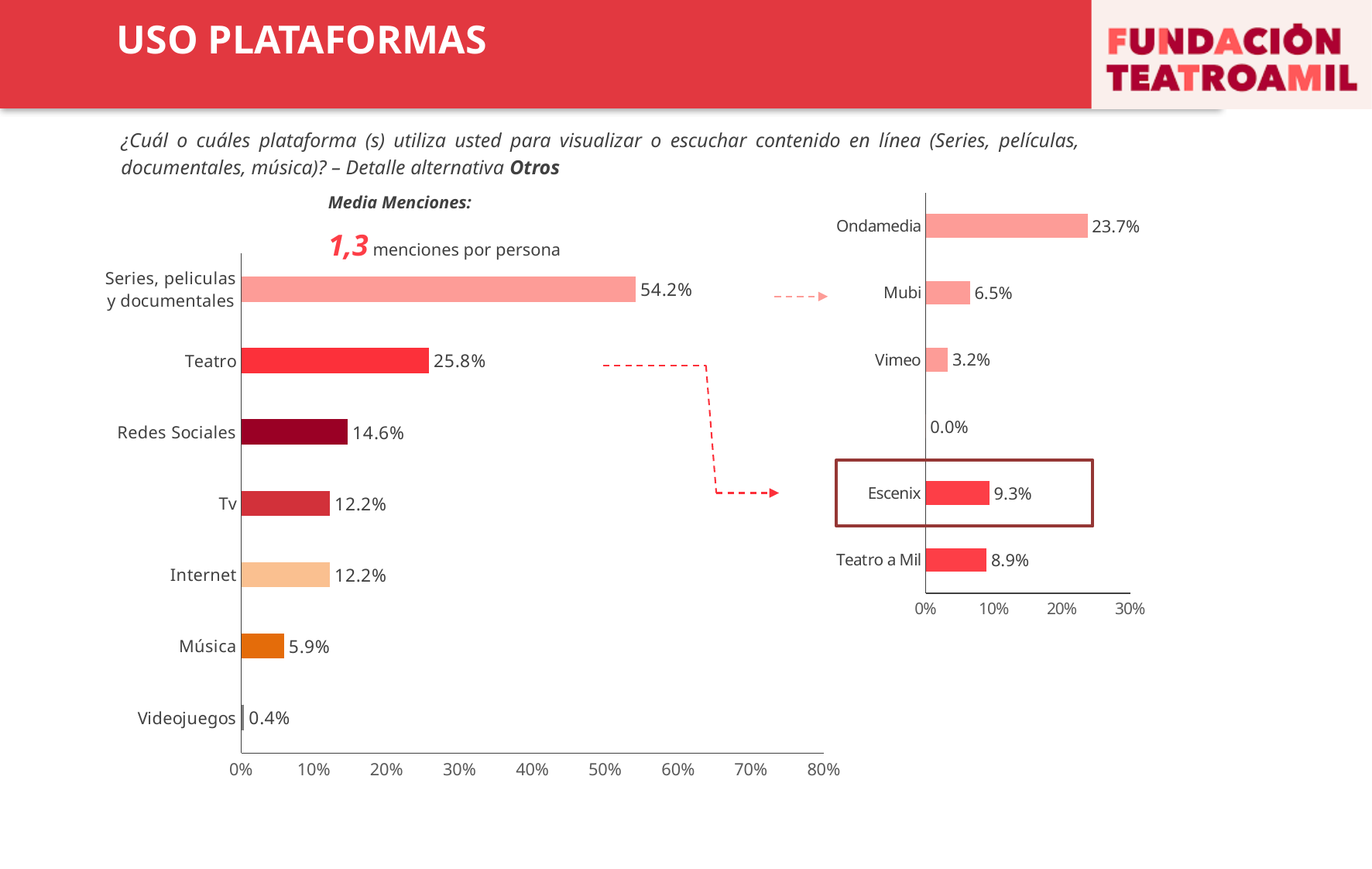
In the left chart, which category has the lowest value? Videojuegos What kind of chart is the left chart? Bar chart In the left chart, how many categories are shown? 7 In the right chart, what is the value for Escenix? 9.3% In the right chart, what is the value for Ondamedia? 23.7% In the right chart, which is larger, Mubi or Vimeo? Mubi In the left chart, what is the value for Teatro? 25.8% In the left chart, is the value for Series, peliculas y documentales greater or less than 50%? greater In the left chart, what is the value for Redes Sociales? 14.6% In the left chart, which category has the highest value? Series, peliculas y documentales In the right chart, what is the difference between the values for Escenix and Teatro a Mil? 0.4% In the left chart, what is the difference between the values for Teatro and Música? 19.9%